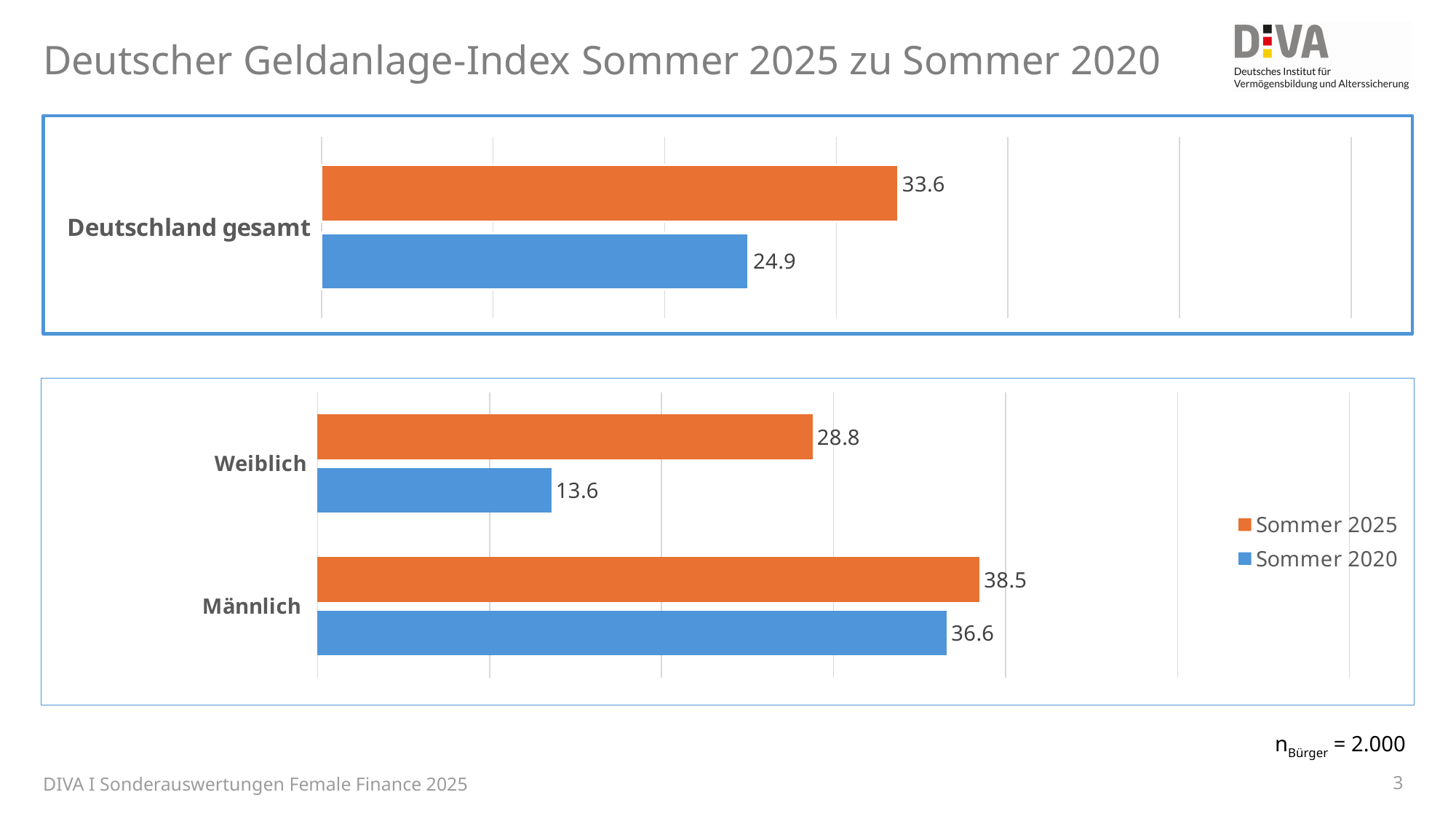
In the bottom chart, which category has the lowest Sommer 2020 value? Weiblich What type of chart is the bottom chart? Bar chart In the bottom chart, which is larger: the Sommer 2025 value for Männlich or for Weiblich? Männlich How many series does the legend on the bottom chart list? 2 In the top chart, what is the value for Deutschland gesamt in Sommer 2020? 24.9 In the top chart, what is the value for Deutschland gesamt in Sommer 2025? 33.6 In the bottom chart, what is the value for Weiblich in Sommer 2025? 28.8 In the bottom chart, what is the value for Männlich in Sommer 2025? 38.5 In the bottom chart, which colour represents Sommer 2020? Blue In the bottom chart, what is the value for Weiblich in Sommer 2020? 13.6 In the bottom chart, what is the difference between the Sommer 2025 and Sommer 2020 values for Weiblich? 15.2 In the top chart, what is the difference between the Sommer 2025 and Sommer 2020 values for Deutschland gesamt? 8.7